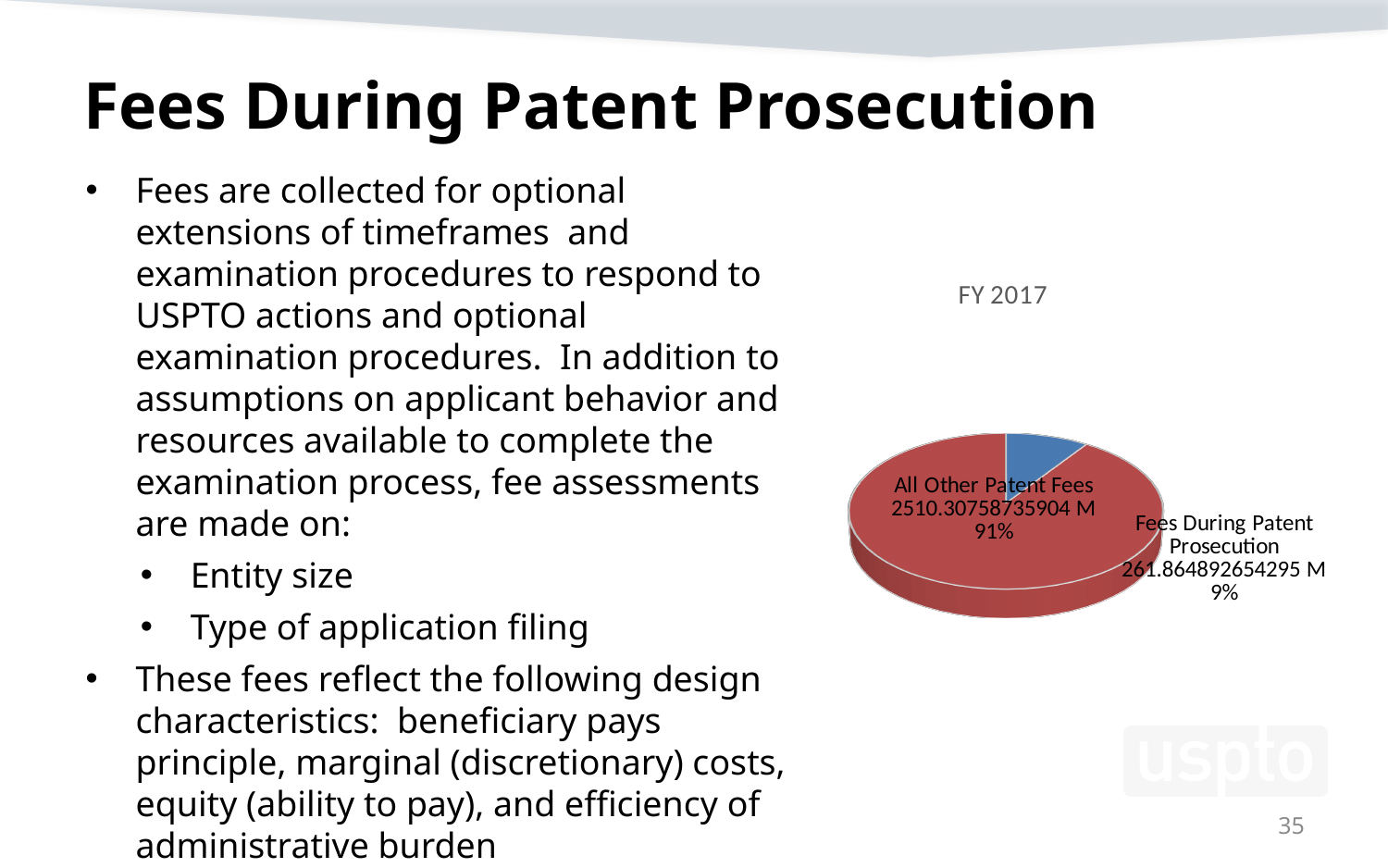
What share of the pie does Fees During Patent Prosecution represent? 9% What share of the pie does All Other Patent Fees represent? 91% What is the value shown for Fees During Patent Prosecution? 261.864892654295 M What kind of chart is shown on the slide? pie chart What is the value shown for All Other Patent Fees? 2510.30758735904 M How many slices does the pie chart have? 2 Which slice of the pie is the largest? All Other Patent Fees What colour is the Fees During Patent Prosecution slice? blue Which slice of the pie is the smallest? Fees During Patent Prosecution What is the difference in percentage share between All Other Patent Fees and Fees During Patent Prosecution? 82% What is the title of the chart? FY 2017 Which is larger, All Other Patent Fees or Fees During Patent Prosecution? All Other Patent Fees